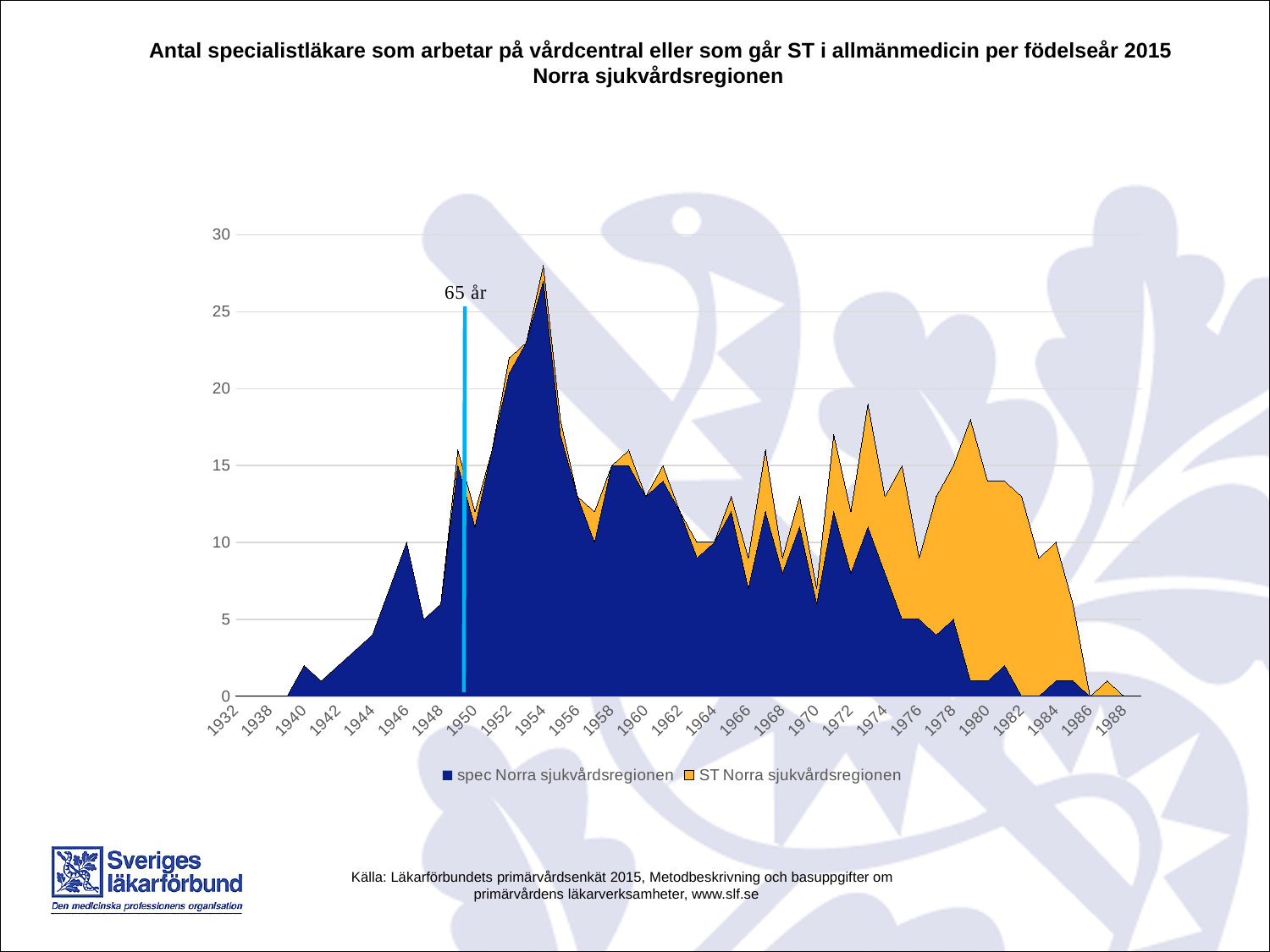
Do the values for spec Norra sjukvårdsregionen generally rise or fall from 1954 to 1988? fall Is the stacked total at 1988 greater or less than 5? less Is the value for spec Norra sjukvårdsregionen at 1954 greater or less than 25? greater What label is written next to the vertical light-blue line at 1950? 65 år How many series does the legend list? 2 What kind of chart is shown on the slide? area chart Is the stacked total at 1980 greater or less than 15? less What are the two series named in the legend? spec Norra sjukvårdsregionen and ST Norra sjukvårdsregionen At 1954, which series has the larger value, spec Norra sjukvårdsregionen or ST Norra sjukvårdsregionen? spec Norra sjukvårdsregionen At 1980, which series has the larger value, spec Norra sjukvårdsregionen or ST Norra sjukvårdsregionen? ST Norra sjukvårdsregionen